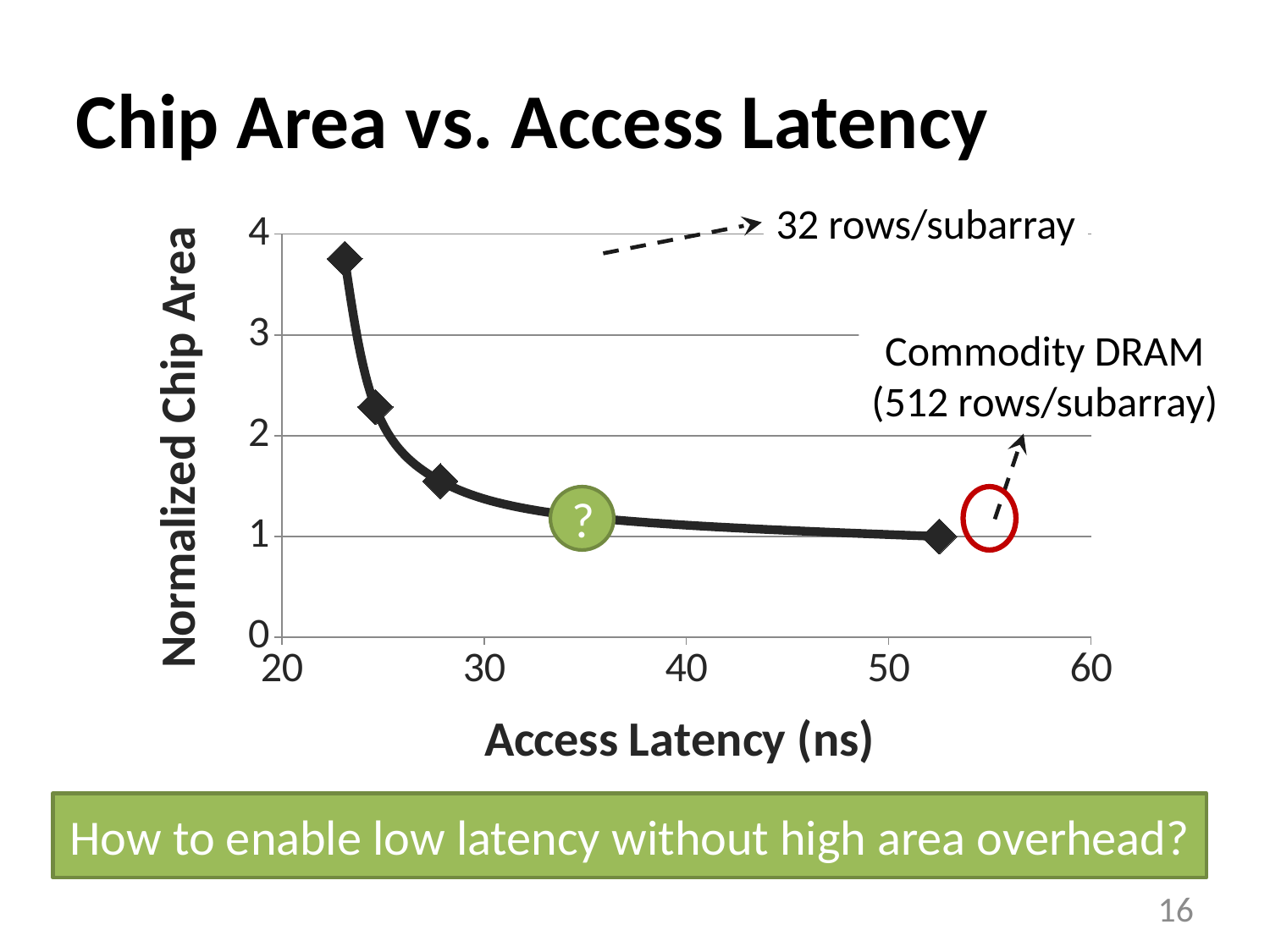
What kind of chart is shown on the slide? line chart Is the access latency of the 32 rows/subarray configuration greater or less than 30 ns? less As access latency increases along the x axis, does normalized chip area rise or fall? fall What is the title of the x axis? Access Latency (ns) Which labelled configuration has the lowest normalized chip area? Commodity DRAM (512 rows/subarray) Which has the larger access latency: 32 rows/subarray or Commodity DRAM (512 rows/subarray)? Commodity DRAM (512 rows/subarray) What is the title of the y axis? Normalized Chip Area Is the normalized chip area for the 32 rows/subarray point greater or less than 3? greater Is the access latency of Commodity DRAM (512 rows/subarray) greater or less than 50 ns? greater Which labelled configuration has the highest normalized chip area? 32 rows/subarray